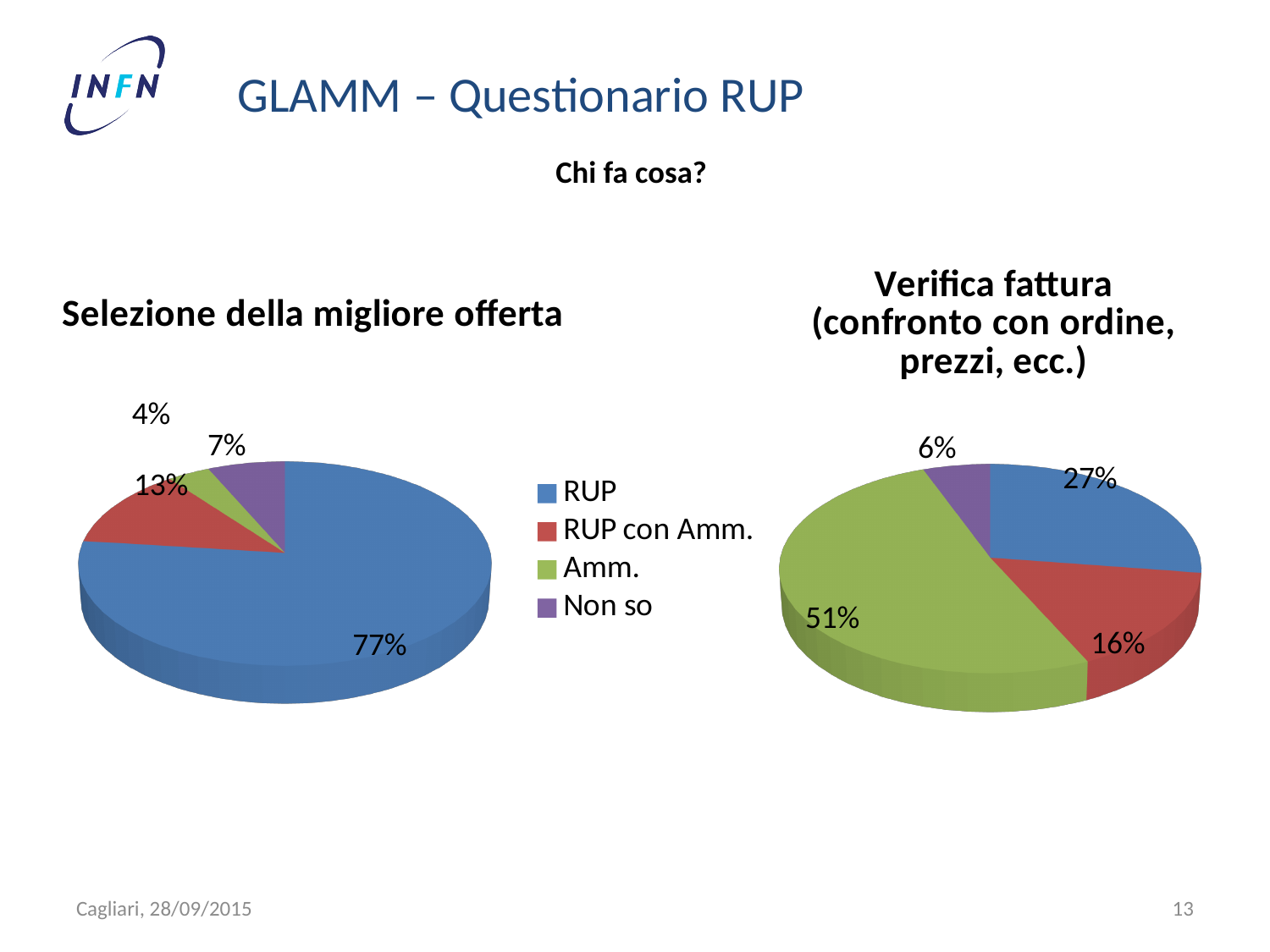
In the 'Verifica fattura' chart, which category has the largest slice? Amm. What is the difference between the RUP share in the 'Selezione della migliore offerta' chart and the RUP share in the 'Verifica fattura' chart? 50 percentage points In the 'Verifica fattura' chart, what share is labelled for Amm.? 51% How many entries does the legend list? 4 In the 'Selezione della migliore offerta' chart, which category has the smallest slice? Amm. In the 'Selezione della migliore offerta' chart, which category has the largest slice? RUP What kind of chart is used for 'Selezione della migliore offerta'? Pie chart In the 'Verifica fattura' chart, which is larger: the RUP con Amm. slice or the Non so slice? RUP con Amm. In the 'Verifica fattura' chart, what share is labelled for Non so? 6% In the 'Verifica fattura' chart, what share is labelled for RUP? 27% In the 'Selezione della migliore offerta' chart, what share is labelled for RUP con Amm.? 13% In the 'Selezione della migliore offerta' chart, what share is labelled for RUP? 77%